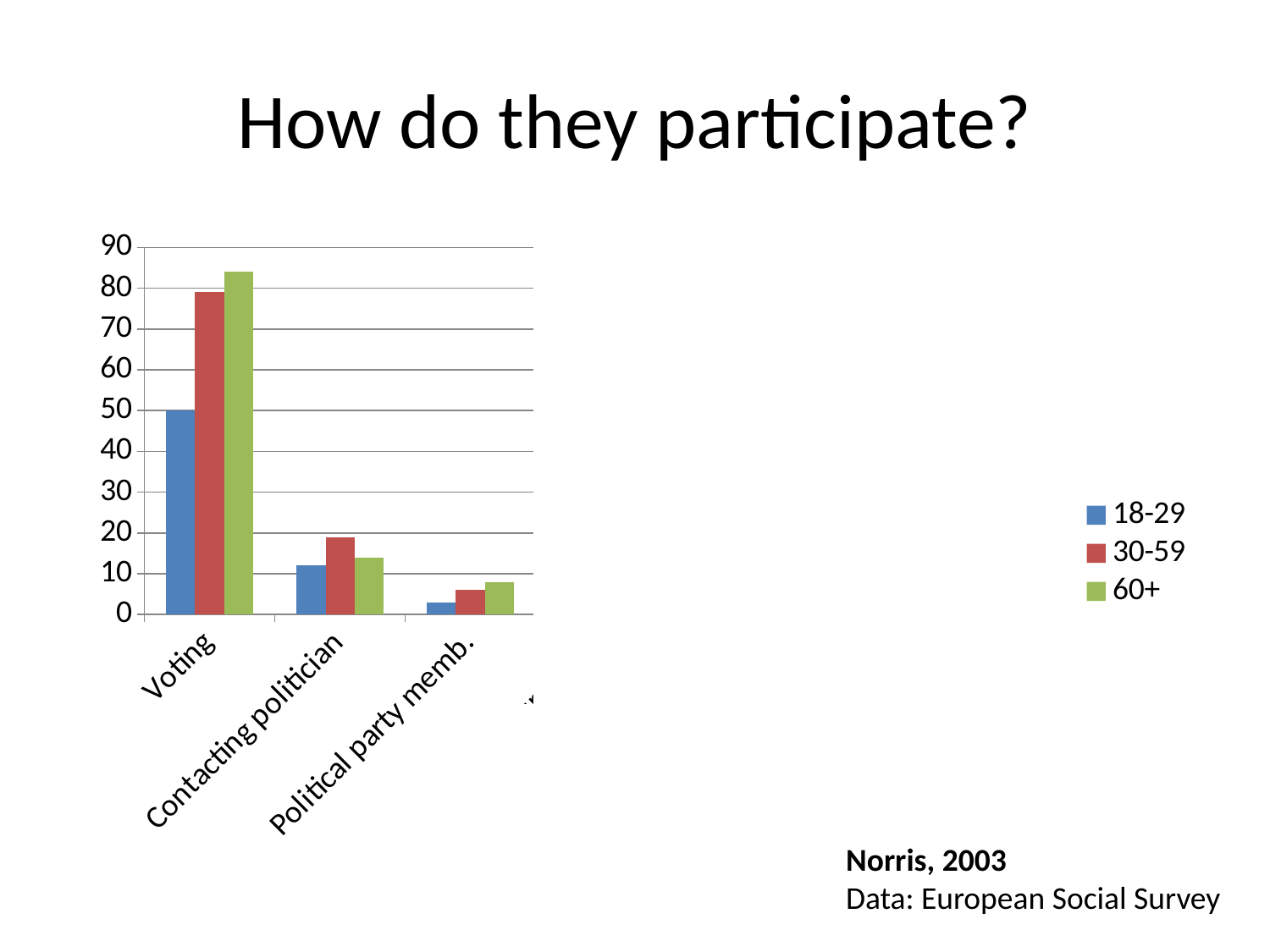
For Voting, which age group has the highest value? 60+ For Contacting politician, which age group has the highest value? 30-59 For Contacting politician, which is larger: the value for 30-59 or the value for 60+? 30-59 How many series does the legend list? 3 What is the title of the slide containing the chart? How do they participate? For Voting, which age group has the lowest value? 18-29 What kind of chart is shown on the slide? bar chart For the 18-29 group, which is larger: the value for Voting or the value for Contacting politician? Voting Is the value for 30-59 in the Voting category greater or less than 70? greater Is the value for 60+ in the Voting category greater or less than 80? greater Is the value for 18-29 in the Contacting politician category greater or less than 20? less